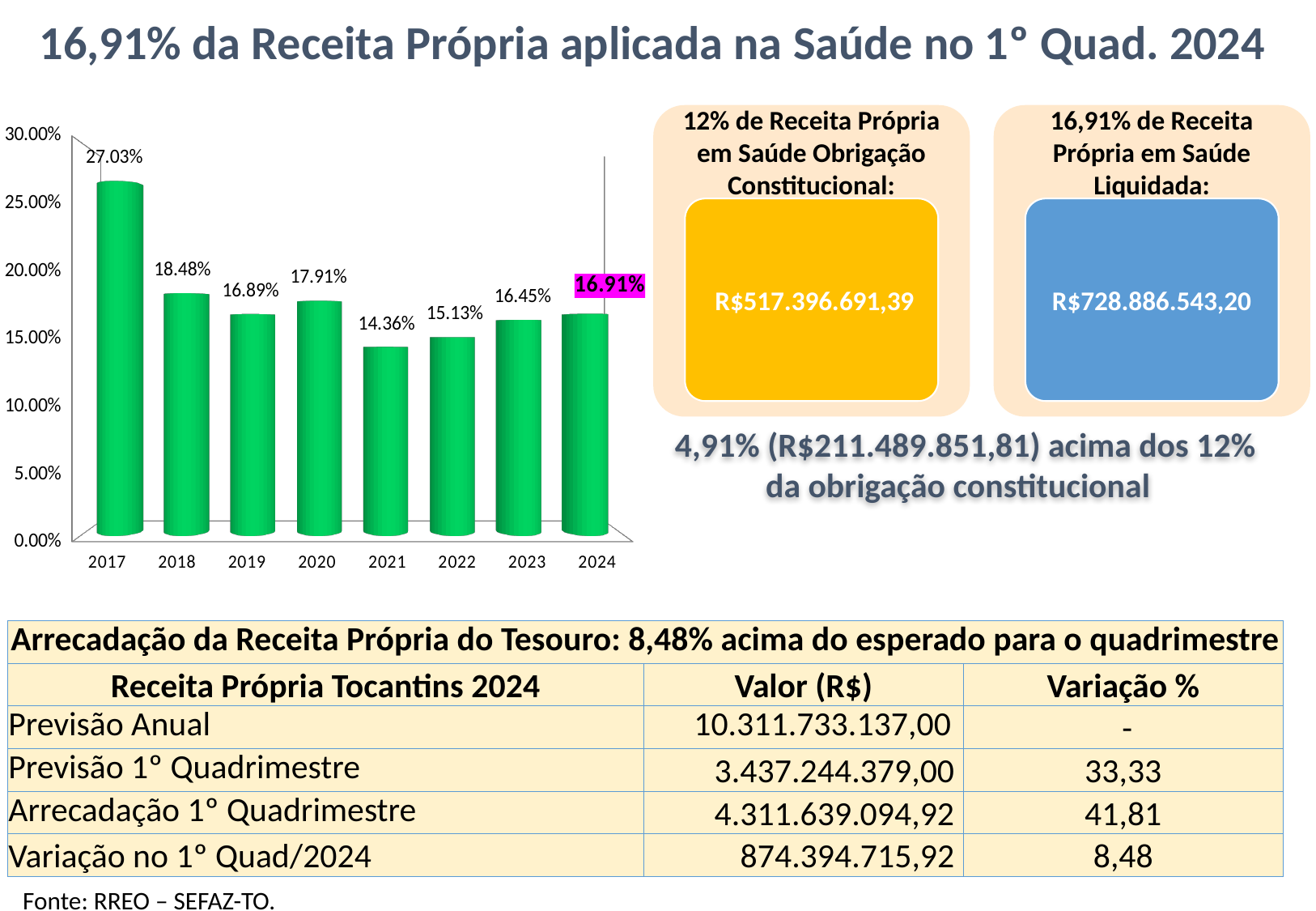
Which year has the highest value in the bar chart? 2017 What kind of chart is shown on the left of the slide? Bar chart What is the value shown for 2021 in the bar chart? 14.36% What is the value shown for 2024 in the bar chart? 16.91% What is the difference between the values for 2017 and 2018 in the bar chart? 8.55 percentage points How many years are shown on the x axis of the bar chart? 8 Does the value in the bar chart rise or fall from 2021 to 2024? Rise Which is larger in the bar chart, the value for 2022 or the value for 2023? 2023 What is the value shown for 2017 in the bar chart? 27.03% Which year has the lowest value in the bar chart? 2021 Is the value for 2018 in the bar chart greater or less than 20.00%? less What is the difference between the values for 2020 and 2019 in the bar chart? 1.02 percentage points